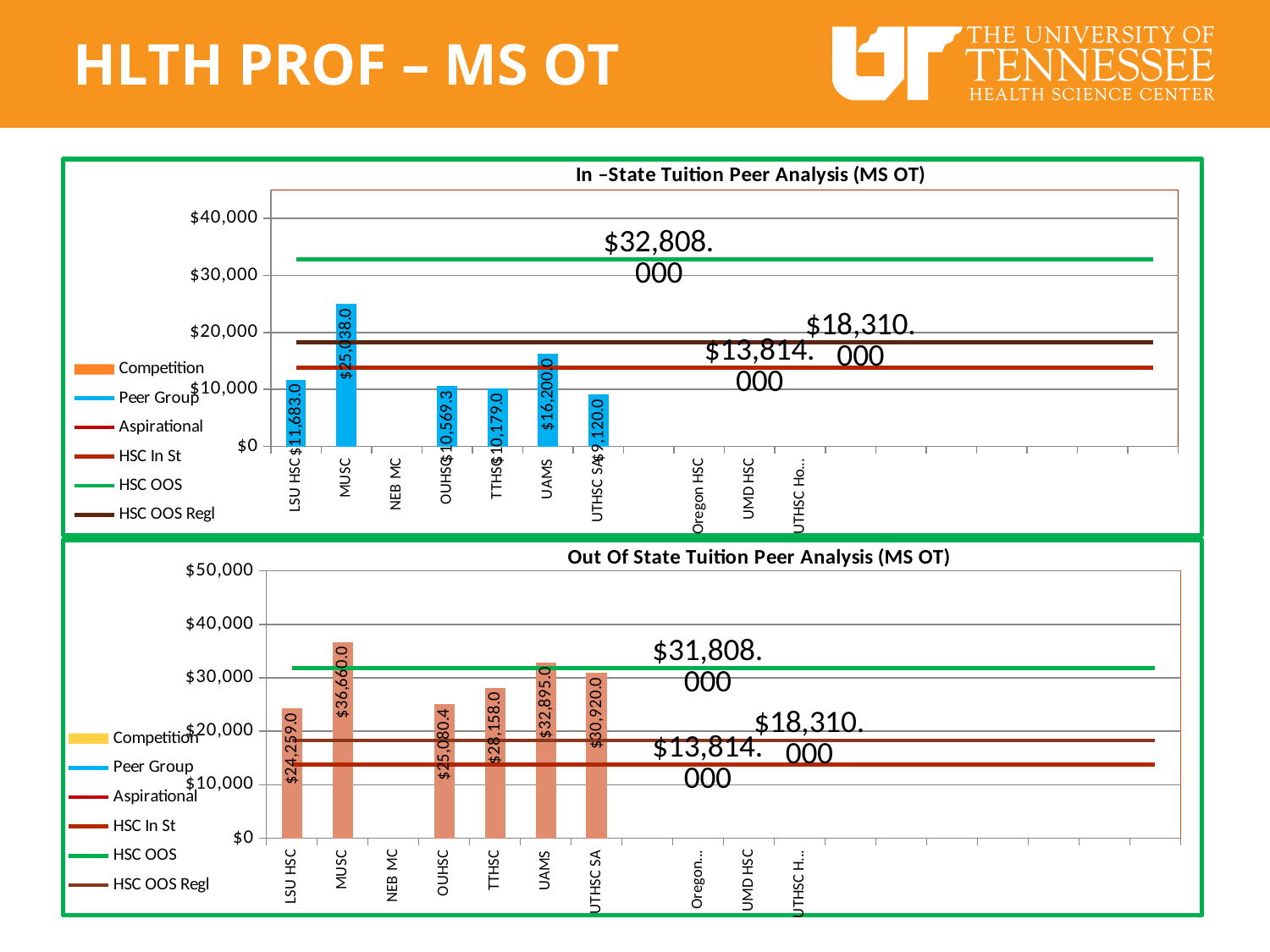
In the Out Of State Tuition Peer Analysis chart, what is the value for TTHSC? $28,158.0 How many entries does the legend of the In-State Tuition Peer Analysis chart list? 6 What type of chart is the Out Of State Tuition Peer Analysis chart? Bar chart In the Out Of State Tuition Peer Analysis chart, which is larger, the value for UAMS or for UTHSC SA? UAMS In the In-State Tuition Peer Analysis chart, what value is shown for the HSC OOS line? $32,808.000 In the Out Of State Tuition Peer Analysis chart, which institution has the highest bar? MUSC In the In-State Tuition Peer Analysis chart, which institution has the highest bar? MUSC In the In-State Tuition Peer Analysis chart, what is the difference between the MUSC and LSU HSC values? $13,355.0 In the Out Of State Tuition Peer Analysis chart, how many bars are plotted? 6 In the In-State Tuition Peer Analysis chart, which institution has the lowest bar? UTHSC SA In the In-State Tuition Peer Analysis chart, what is the value for MUSC? $25,038.0 In the Out Of State Tuition Peer Analysis chart, what is the value for MUSC? $36,660.0